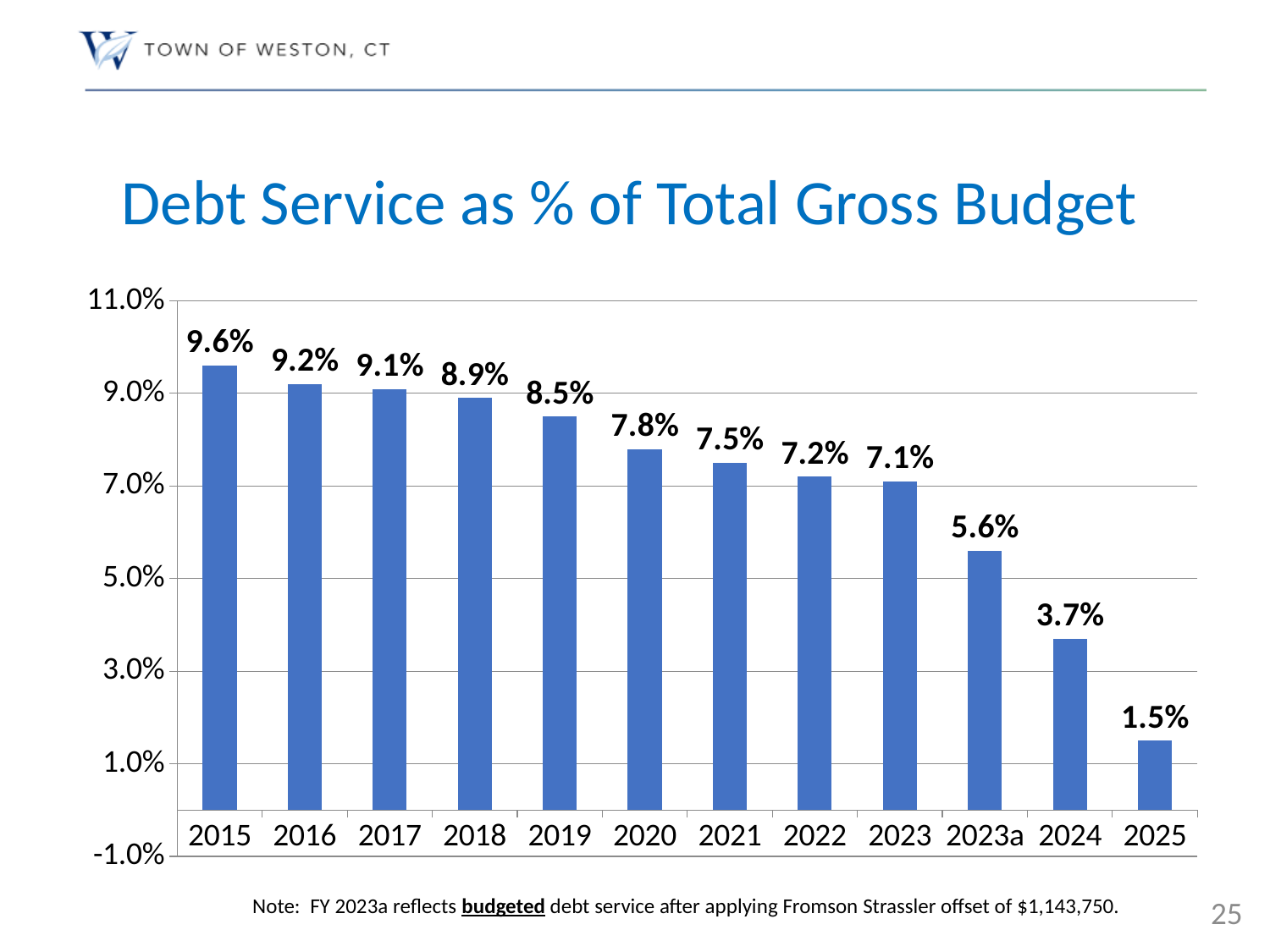
What is the difference between the values for 2015 and 2025? 8.1% Which is larger, the value for 2019 or the value for 2021? 2019 What is the debt service as a percentage of total gross budget for 2015? 9.6% Which year has the highest debt service as a percentage of total gross budget? 2015 How many categories are shown on the x axis? 12 What value is shown for 2023a? 5.6% Do the values rise or fall from 2015 to 2025? fall What is the value for 2025? 1.5% Which year has the lowest value on the chart? 2025 Is the value for 2024 greater or less than 5.0%? less What is the difference between the values for 2023 and 2023a? 1.5% What kind of chart is shown on the slide? bar chart